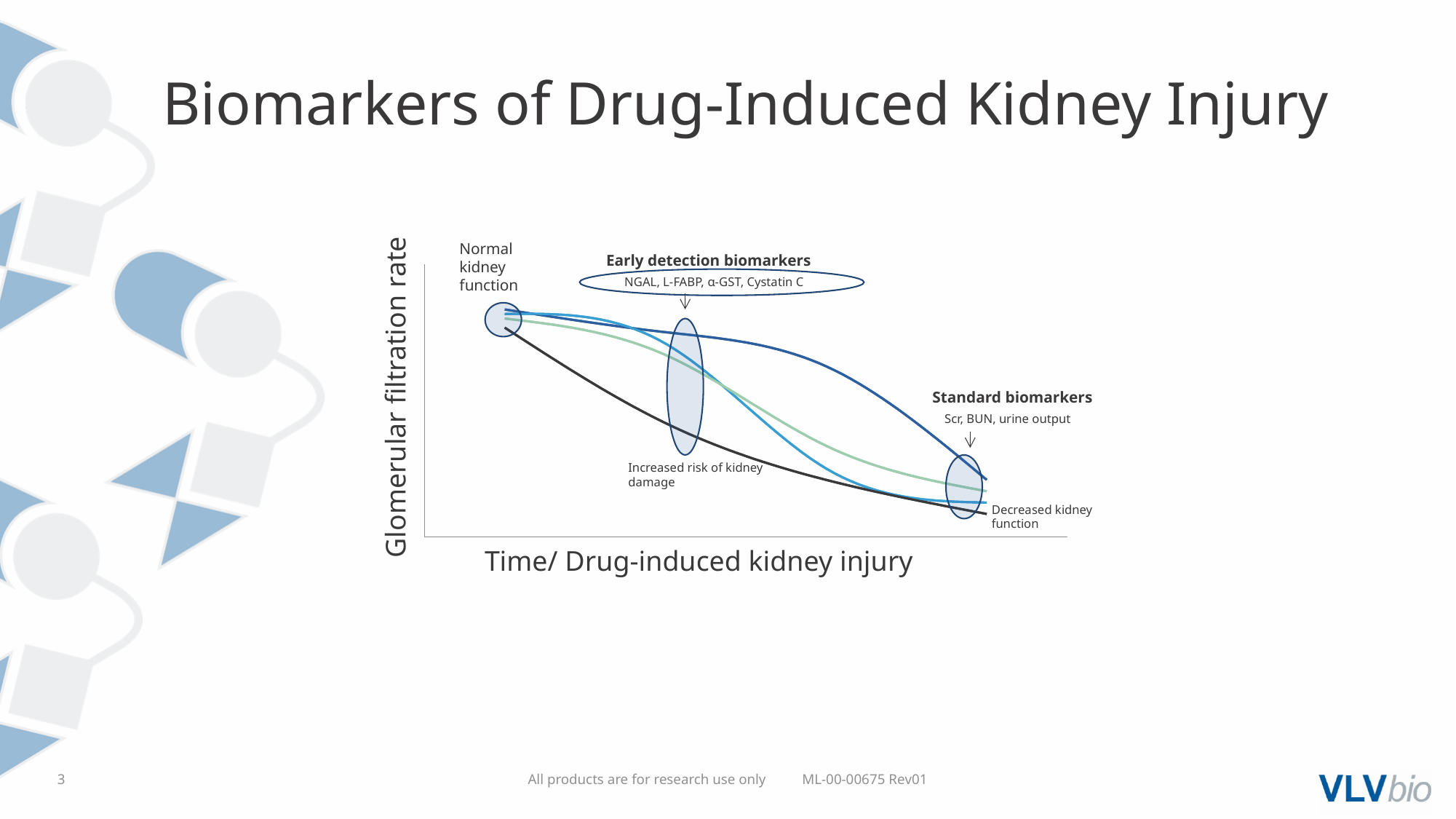
Which biomarkers are listed as early detection biomarkers on the chart? NGAL, L-FABP, α-GST, Cystatin C Does the black curve rise or fall as time increases? fall What is the label of the y axis? Glomerular filtration rate How many curves are plotted on the chart? 4 What kind of chart is shown on the slide? line chart Do the curves rise or fall along the x axis from left to right? fall